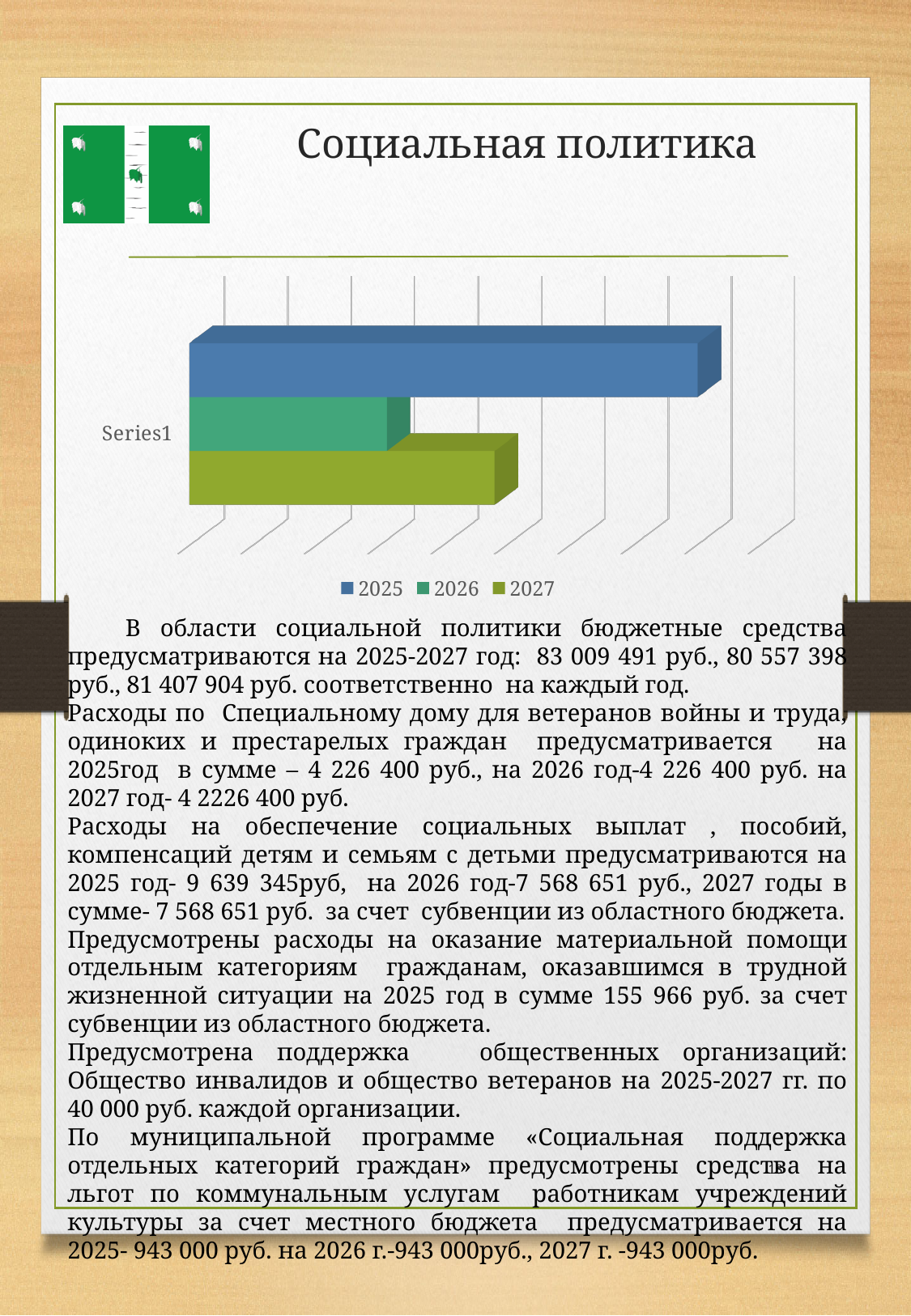
Which bar is longer, 2025 or 2026? 2025 Which year has the longest bar in the chart? 2025 How many categories are shown on the vertical axis of the chart? 1 How many series does the chart legend list? 3 Which bar is longer, 2025 or 2027? 2025 What kind of chart is shown on the slide? bar chart What is the label of the category on the vertical axis of the chart? Series1 Which year has the shortest bar in the chart? 2026 Are the bars in the chart drawn horizontally or vertically? horizontally Which bar is longer, 2026 or 2027? 2027 What are the entries listed in the chart legend? 2025, 2026, 2027